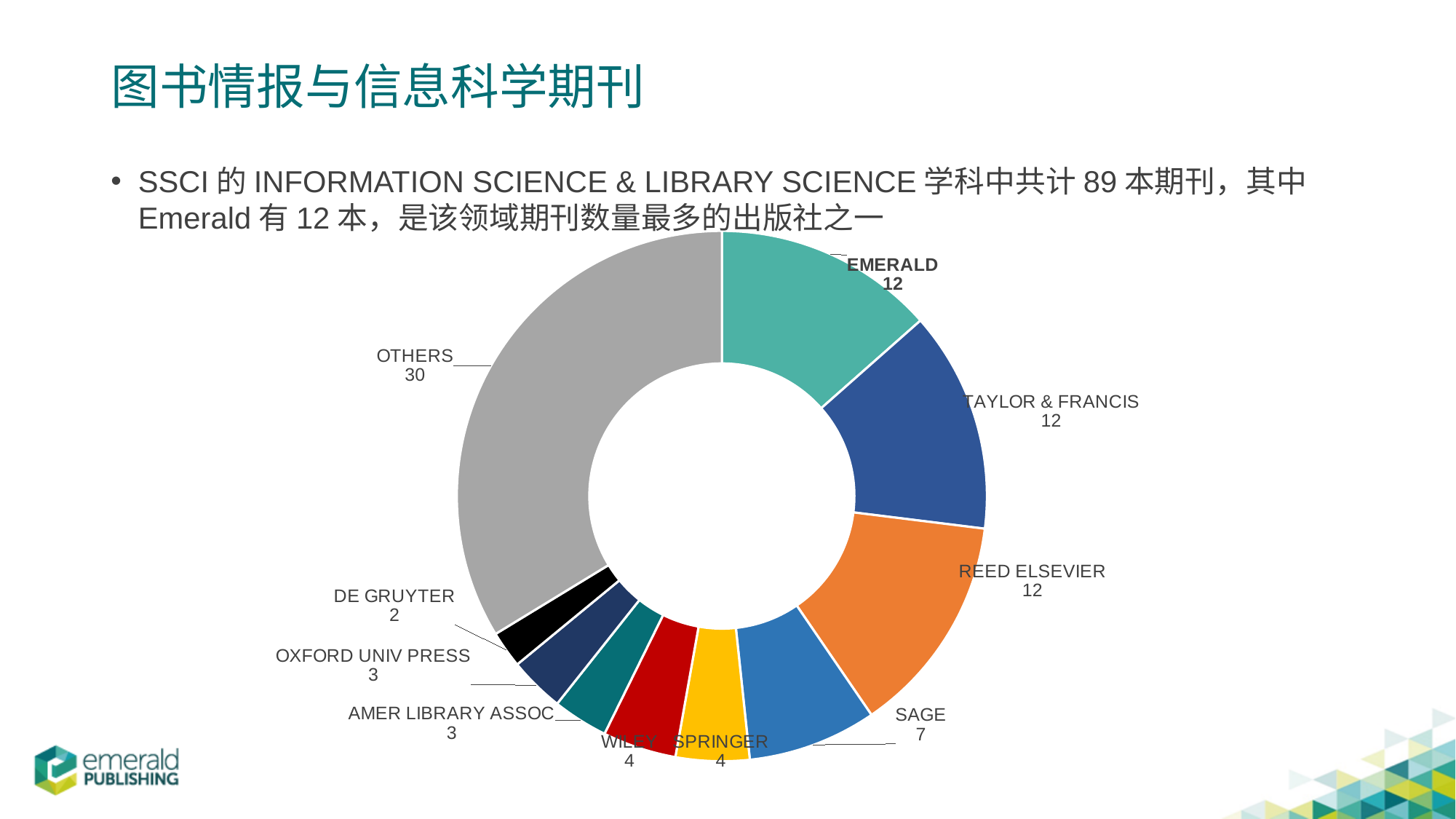
Which is larger, the value for SAGE or the value for WILEY? SAGE What is the value for EMERALD in the chart? 12 What is the total of all the values shown in the chart? 89 What kind of chart is shown on the slide? Doughnut (pie) chart What is the value for DE GRUYTER in the chart? 2 Which category has the smallest value in the chart? DE GRUYTER What is the difference between the values for OTHERS and EMERALD? 18 How many categories (publishers) are shown in the chart? 10 What is the value for SAGE in the chart? 7 Which category has the largest value in the chart? OTHERS What is the value for OTHERS in the chart? 30 What is the difference between the values for SAGE and SPRINGER? 3